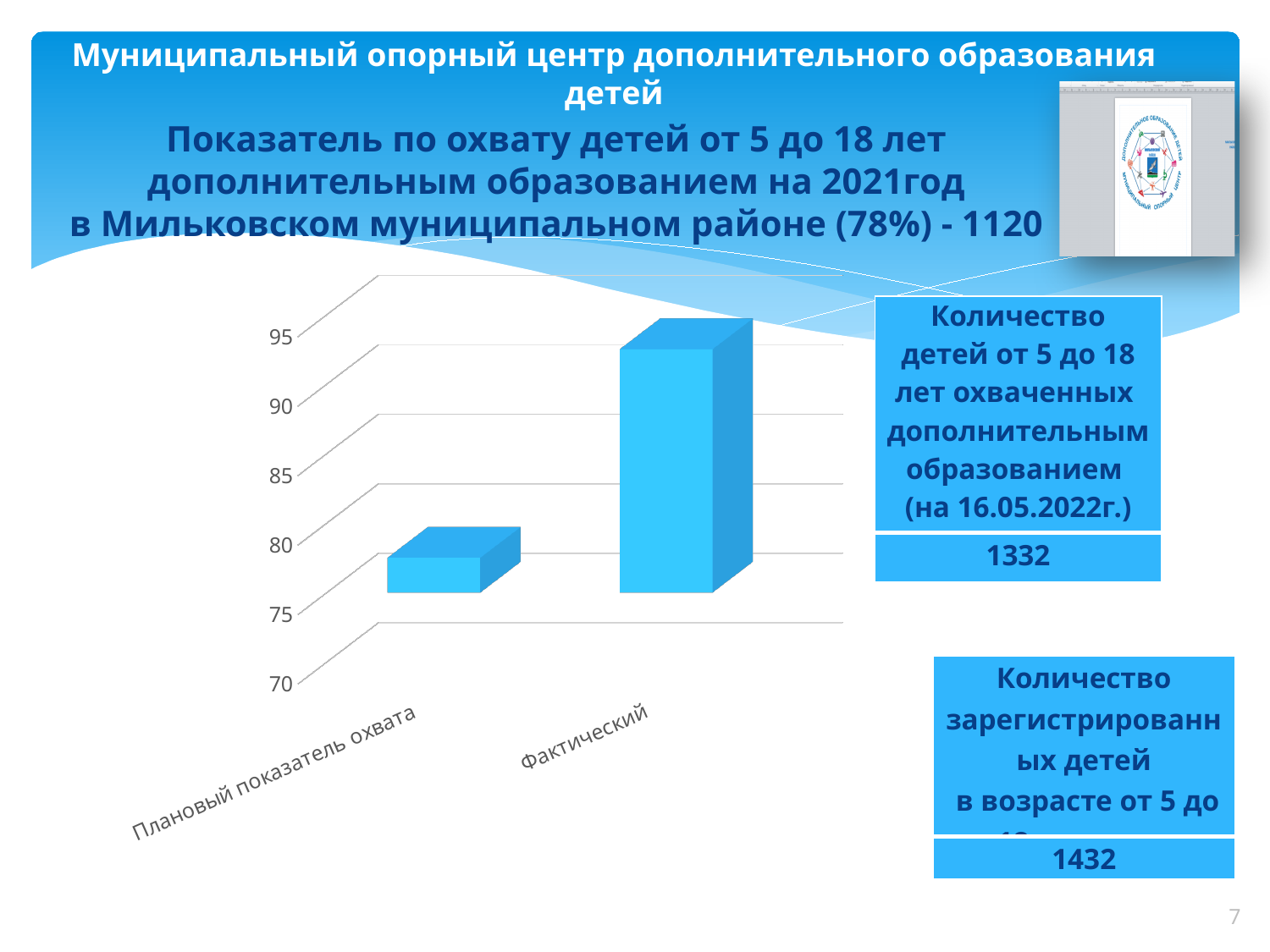
Is the value for Фактический greater or less than 90? greater What is the lowest value shown on the chart's vertical axis? 70 Which category has the highest bar in the chart? Фактический Which is larger in the chart: Плановый показатель охвата or Фактический? Фактический Do the bar values rise or fall from Плановый показатель охвата to Фактический? rise Which category has the lowest bar in the chart? Плановый показатель охвата What is the highest value shown on the chart's vertical axis? 95 Is the value for Плановый показатель охвата greater or less than 75? greater What kind of chart is shown on the slide? bar chart How many categories are shown on the x axis of the chart? 2 Is the value for Фактический greater or less than 95? less